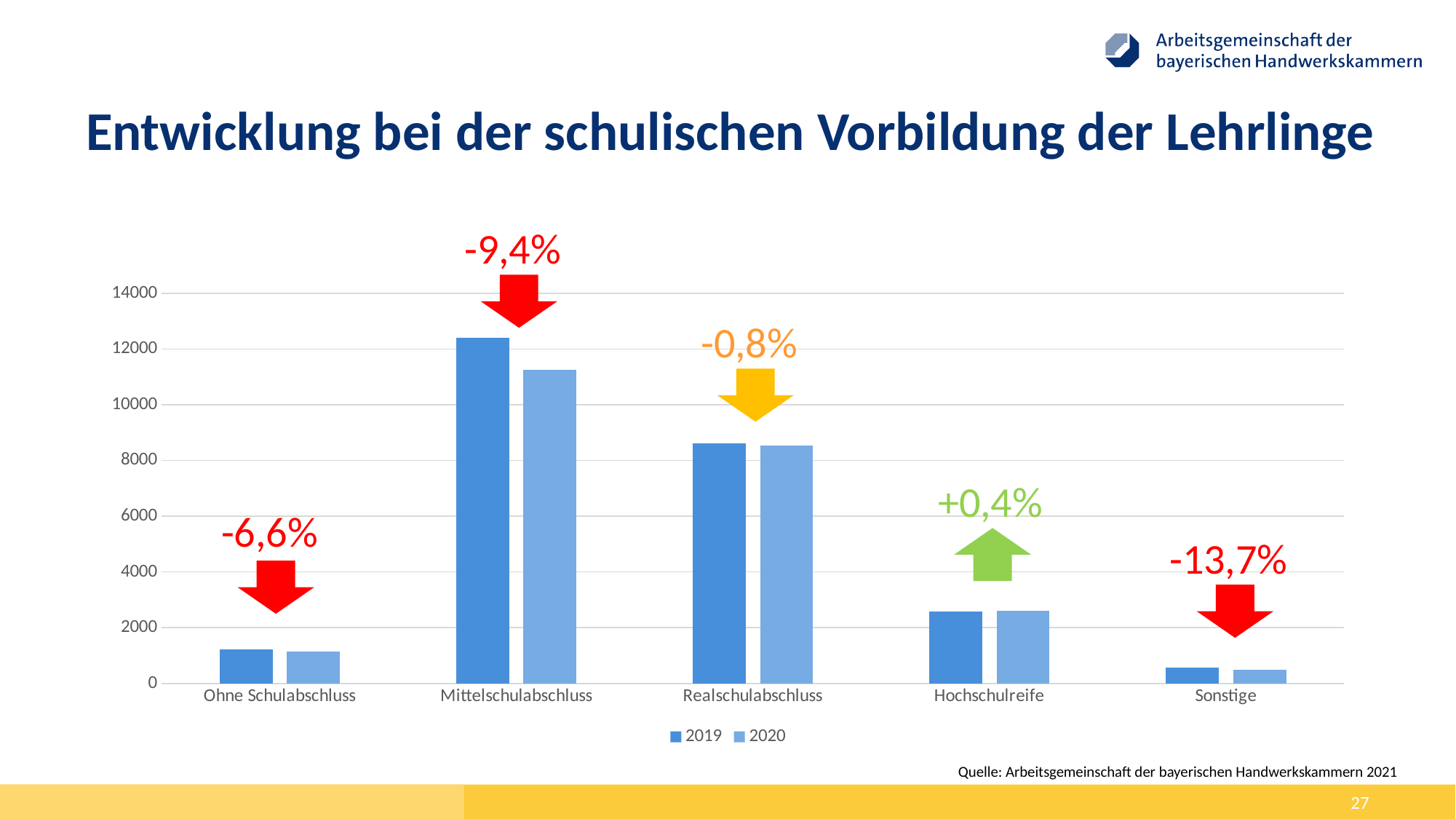
What percentage change is printed above the Mittelschulabschluss bars? -9,4% Which category has the highest bars in the chart? Mittelschulabschluss What kind of chart is shown on the slide? bar chart Is the 2019 value for Realschulabschluss greater or less than 8000? greater Which category has the lowest bars in the chart? Sonstige What percentage change is printed above the Hochschulreife bars? +0,4% For Mittelschulabschluss, which year has the larger value, 2019 or 2020? 2019 How many categories are shown on the x axis of the chart? 5 Is the 2020 value for Mittelschulabschluss greater or less than 12000? less What percentage change is printed above the Sonstige bars? -13,7% How many series does the legend list? 2 Is the 2019 value for Mittelschulabschluss greater or less than 12000? greater